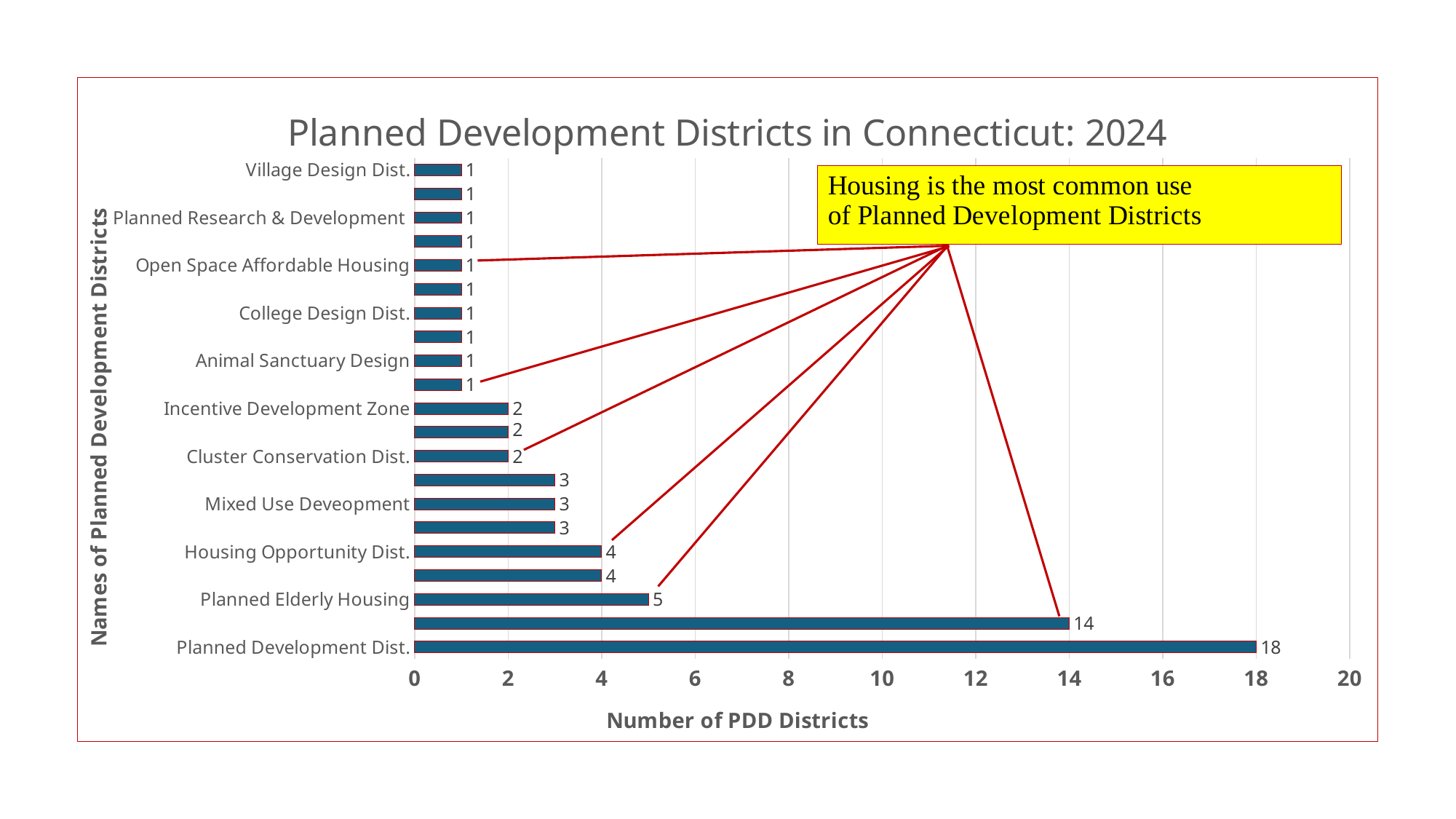
What is the title of the chart? Planned Development Districts in Connecticut: 2024 What is the difference between the values for Planned Development Dist. and Planned Elderly Housing? 13 Which is larger, the value for Housing Opportunity Dist. or the value for Mixed Use Deveopment? Housing Opportunity Dist. What is the label of the horizontal axis? Number of PDD Districts What is the value for Cluster Conservation Dist.? 2 Which category has the highest number of PDD districts? Planned Development Dist. What is the value for Village Design Dist.? 1 What type of chart is shown on the slide? Bar chart How many PDD districts are shown for Planned Development Dist.? 18 What is the value for Housing Opportunity Dist.? 4 Is the value for Planned Development Dist. greater or less than 16? greater What is the value for Planned Elderly Housing? 5